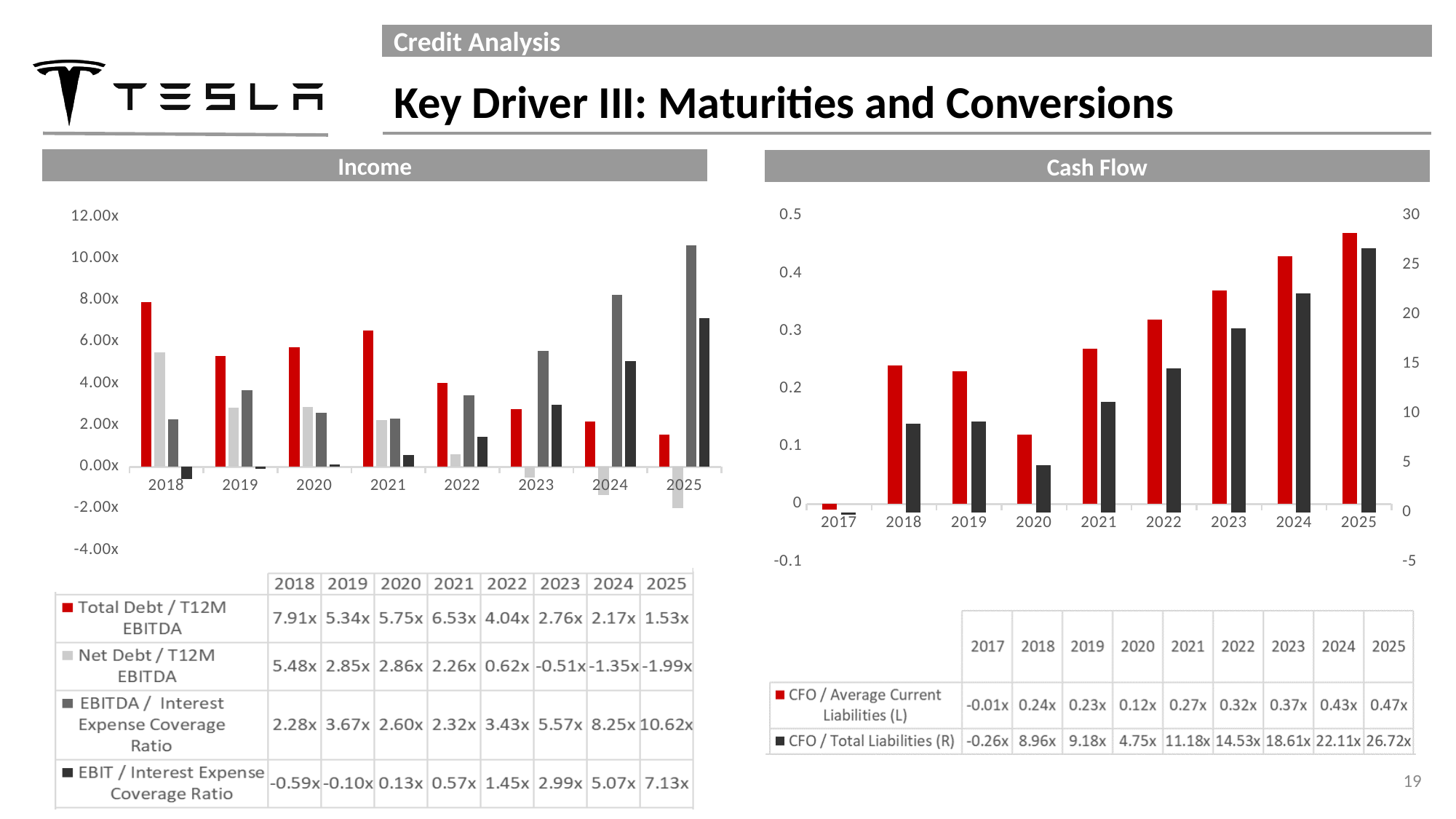
How many series does the legend of the Income chart list? 4 On the Cash Flow chart, what is the CFO / Average Current Liabilities (L) value for 2020? 0.12x On the Income chart, what is the Total Debt / T12M EBITDA value for 2018? 7.91x On the Cash Flow chart, in which year is CFO / Total Liabilities (R) lowest? 2017 What type of chart is the Cash Flow chart? Bar chart On the Income chart, in which year is Total Debt / T12M EBITDA highest? 2018 On the Cash Flow chart, what is the CFO / Total Liabilities (R) value for 2025? 26.72x On the Income chart, what is the EBITDA / Interest Expense Coverage Ratio for 2025? 10.62x On the Income chart, what is the difference between Total Debt / T12M EBITDA in 2018 and in 2025? 6.38x On the Income chart, which year has the larger Total Debt / T12M EBITDA, 2020 or 2021? 2021 How many years are shown on the Cash Flow chart? 9 On the Income chart, does the EBIT / Interest Expense Coverage Ratio rise or fall from 2018 to 2025? Rise